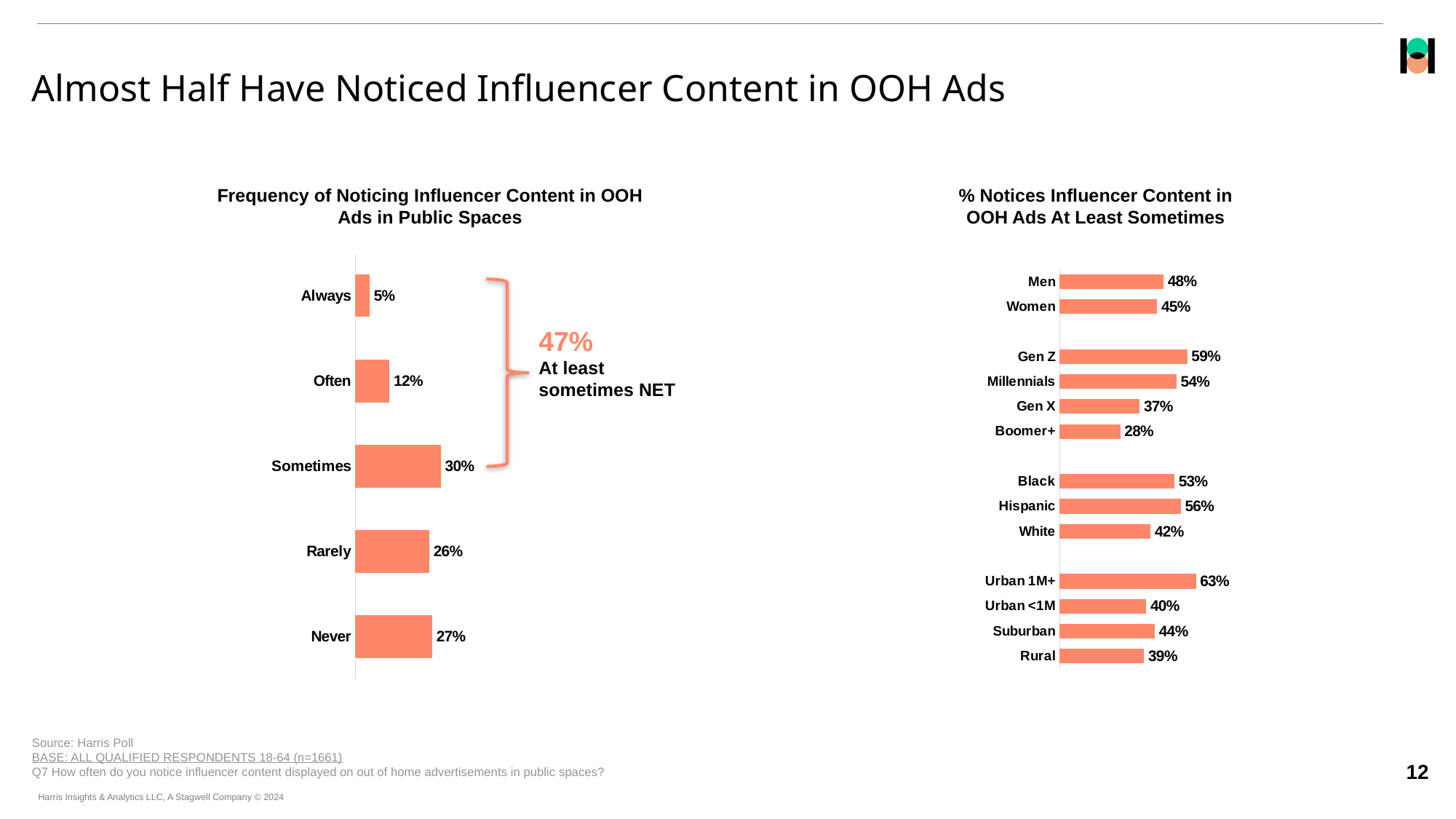
In the '% Notices Influencer Content in OOH Ads At Least Sometimes' chart, which is larger, Hispanic or Black? Hispanic In the '% Notices Influencer Content in OOH Ads At Least Sometimes' chart, how many categories are shown? 13 In the '% Notices Influencer Content in OOH Ads At Least Sometimes' chart, which category has the highest value? Urban 1M+ What kind of chart is the '% Notices Influencer Content in OOH Ads At Least Sometimes' chart? Bar chart In the '% Notices Influencer Content in OOH Ads At Least Sometimes' chart, what is the difference between Men and Women? 3% In the '% Notices Influencer Content in OOH Ads At Least Sometimes' chart, which category has the lowest value? Boomer+ In the '% Notices Influencer Content in OOH Ads At Least Sometimes' chart, what is the value for Gen Z? 59% In the 'Frequency of Noticing Influencer Content in OOH Ads in Public Spaces' chart, what is the 'At least sometimes NET' value shown? 47% In the 'Frequency of Noticing Influencer Content in OOH Ads in Public Spaces' chart, what is the difference between Never and Rarely? 1% In the 'Frequency of Noticing Influencer Content in OOH Ads in Public Spaces' chart, how many categories are shown? 5 In the 'Frequency of Noticing Influencer Content in OOH Ads in Public Spaces' chart, which category has the lowest value? Always In the 'Frequency of Noticing Influencer Content in OOH Ads in Public Spaces' chart, what is the value for Sometimes? 30%